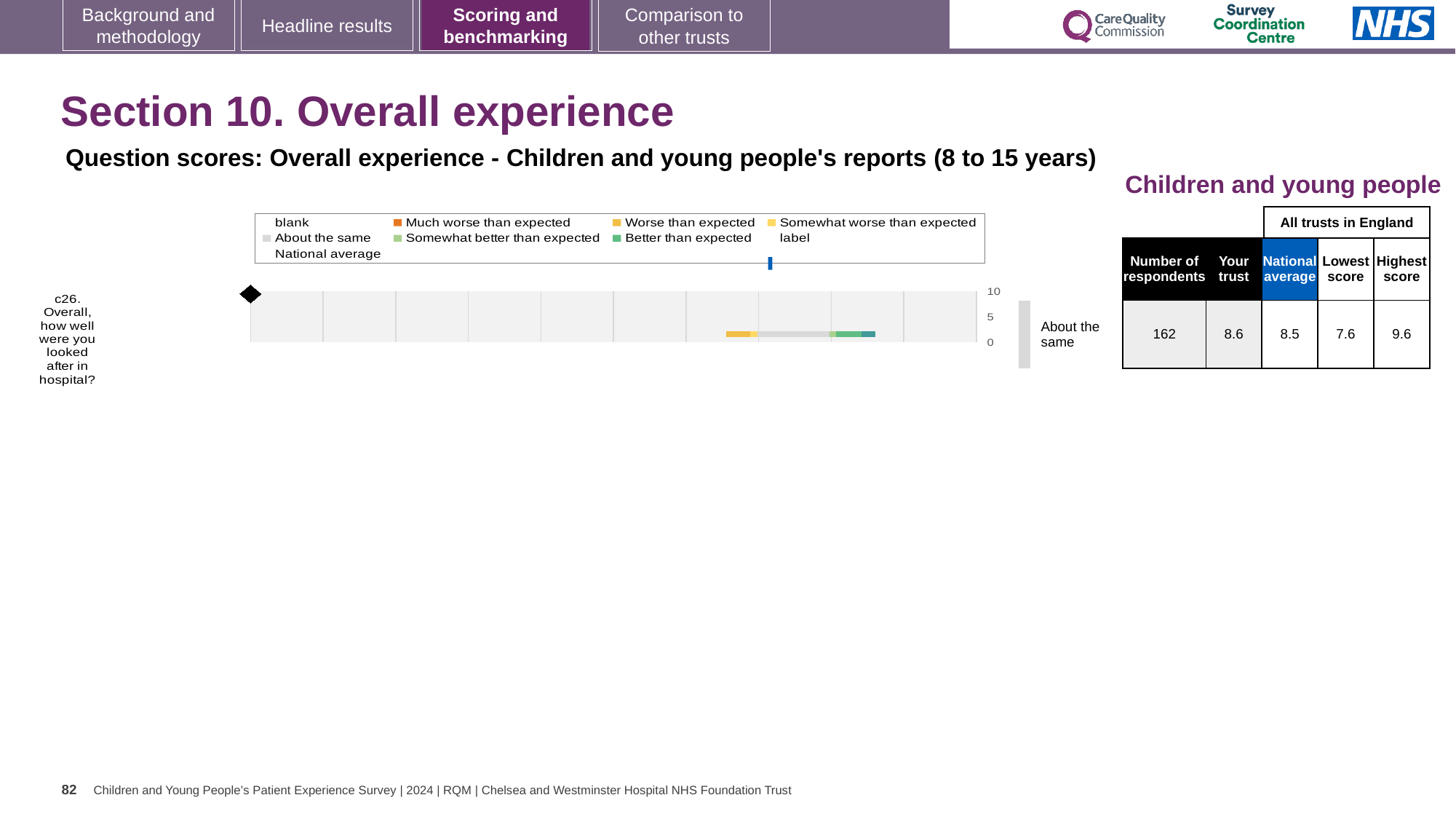
In the table beside the chart, how many respondents answered question c26? 162 How many survey questions are plotted in the chart? 1 What kind of chart is used to show the score for question c26? bar chart What is the highest tick value shown on the chart's score axis? 10 In the table beside the chart, what is the 'Your trust' score for question c26? 8.6 In the table beside the chart, what is the national average score for question c26? 8.5 In the table beside the chart, what is the lowest score among all trusts in England for question c26? 7.6 What benchmark category is written to the right of the bar for question c26? About the same For question c26, what is the difference between the 'Your trust' score and the national average? 0.1 In the table beside the chart, what is the highest score among all trusts in England for question c26? 9.6 For question c26, what is the difference between the highest score and the lowest score among all trusts in England? 2.0 For question c26, which is higher: the 'Your trust' score or the national average? Your trust